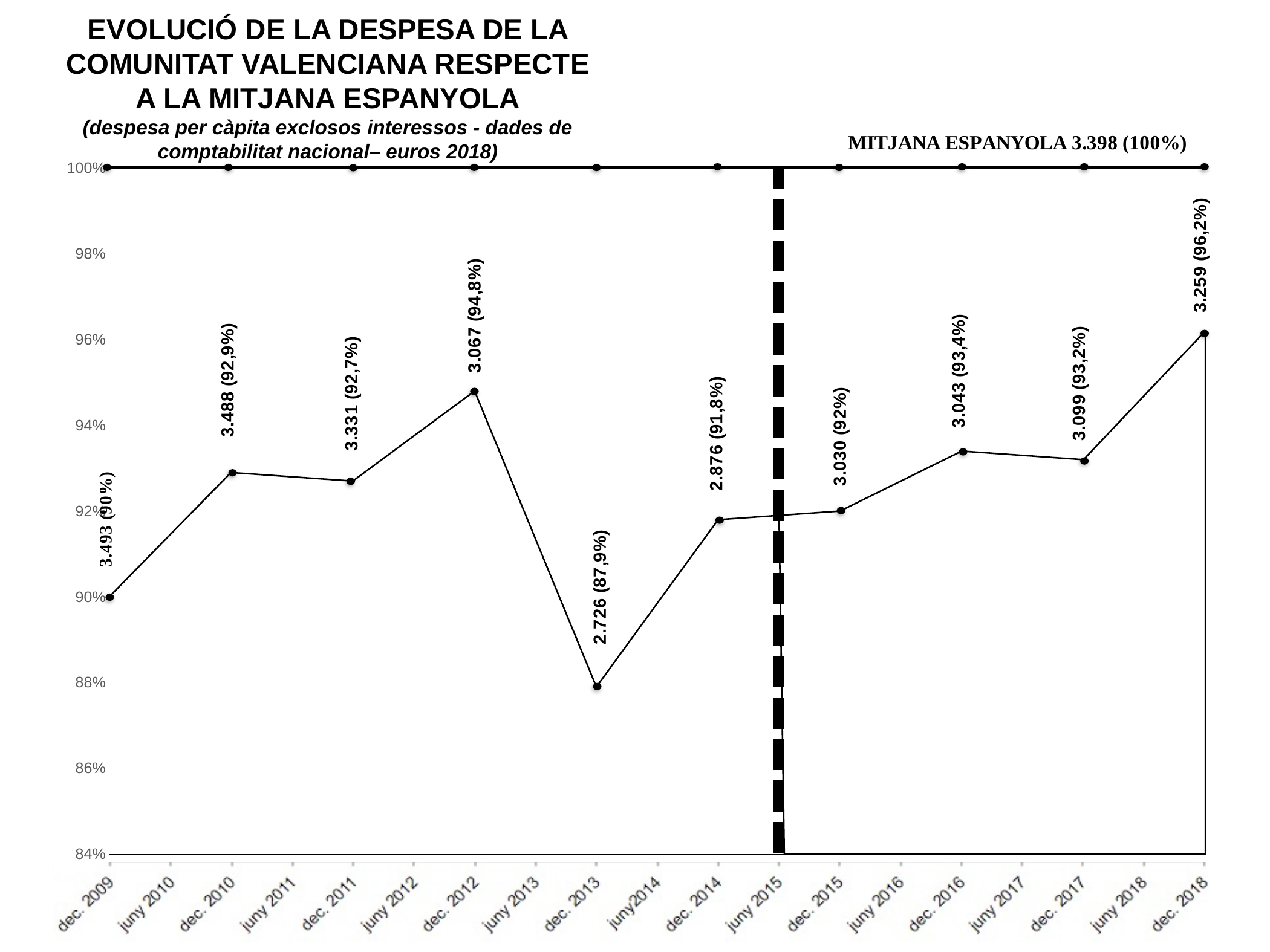
How many data points are plotted on the Comunitat Valenciana line? 10 Is the percentage for dec. 2016 higher or lower than the percentage for dec. 2017? higher What percentage of the Spanish average is shown for dec. 2018? 96,2% What value is given for the Spanish average (MITJANA ESPANYOLA)? 3.398 (100%) Which date has the lowest percentage relative to the Spanish average? dec. 2013 What is the per-capita spending value labelled for dec. 2012? 3.067 What is the difference in percentage points between dec. 2018 (96,2%) and dec. 2013 (87,9%)? 8,3 What is the data label for dec. 2013? 2.726 (87,9%) Does the line rise or fall between dec. 2012 and dec. 2013? fall What kind of chart is shown on the slide? line chart Which date has the highest percentage relative to the Spanish average? dec. 2018 What percentage is labelled for dec. 2015? 92%